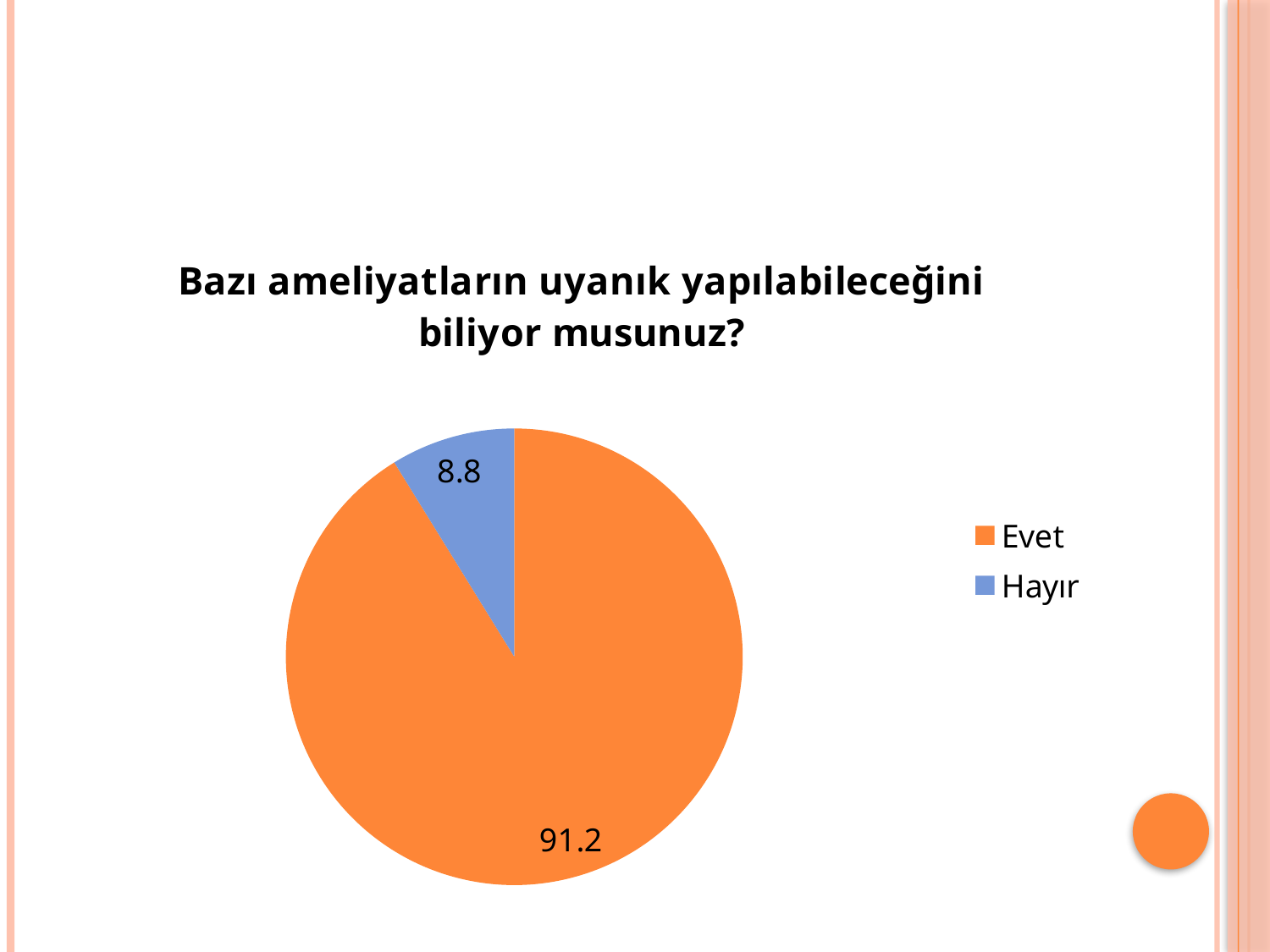
Which category has the largest slice? Evet What is the title of the chart? Bazı ameliyatların uyanık yapılabileceğini biliyor musunuz? Which is larger, the value for Evet or the value for Hayır? Evet What is the value for Hayır? 8.8 Which category has the smallest slice? Hayır How many entries does the legend list? 2 What is the difference between the values for Evet and Hayır? 82.4 What is the value for Evet? 91.2 How many slices does the pie chart have? 2 What kind of chart is shown on the slide? pie chart What colour is the Hayır slice? blue What is the total of the two slice values? 100